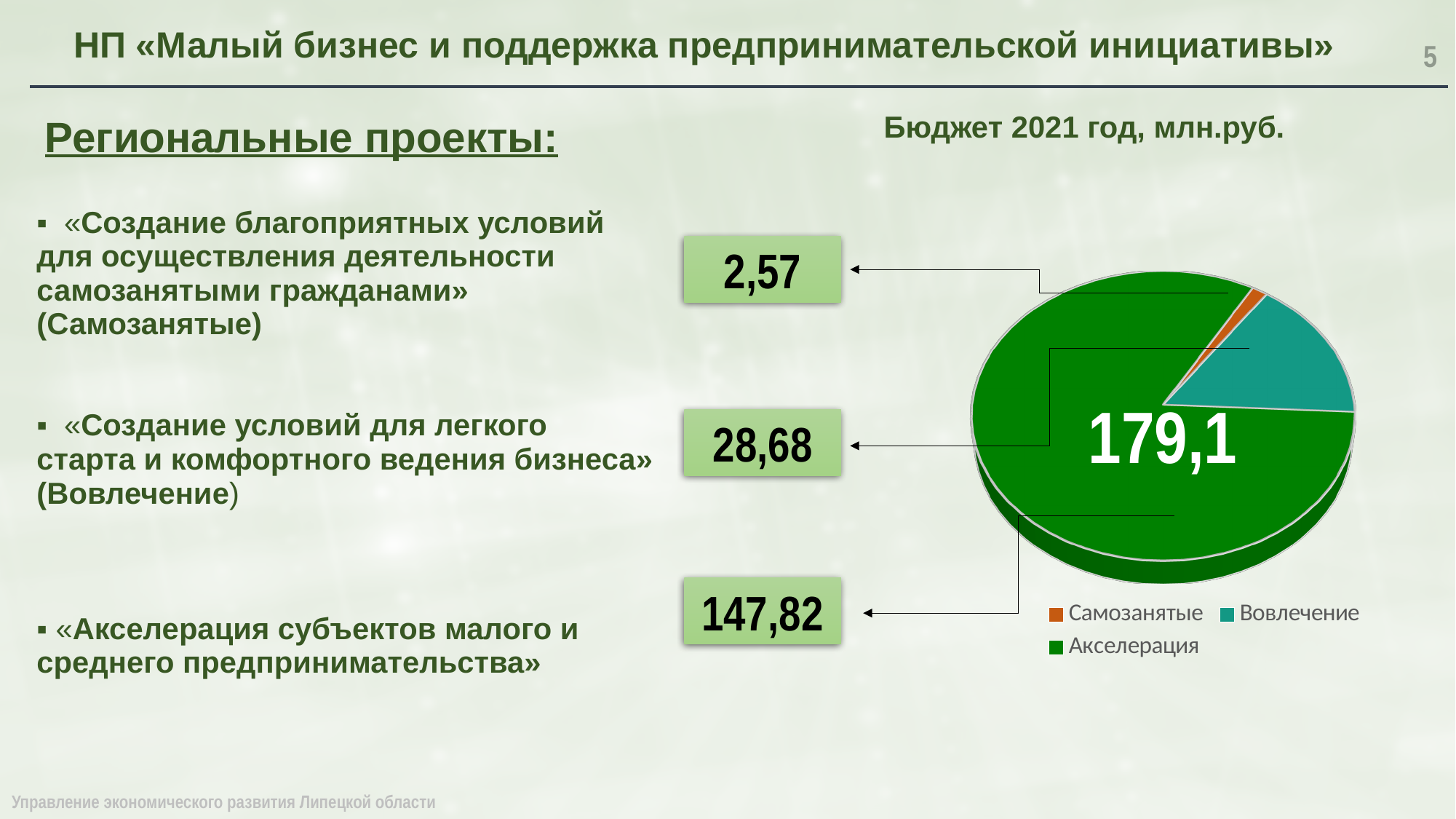
Which slice of the pie chart is the smallest? Самозанятые What is the budget value for Акселерация in the pie chart? 147,82 How many entries does the legend of the pie chart list? 3 What is the total value shown in the centre of the pie chart? 179,1 What is the difference between the values for Вовлечение and Самозанятые? 26,11 What is the difference between the values for Акселерация and Вовлечение? 119,14 What is the budget value for Самозанятые in the pie chart? 2,57 What type of chart is shown on the slide? pie chart What is the budget value for Вовлечение in the pie chart? 28,68 What colour is the Вовлечение slice in the pie chart? teal Which slice of the pie chart is the largest? Акселерация Which is larger, the value for Вовлечение or the value for Самозанятые? Вовлечение